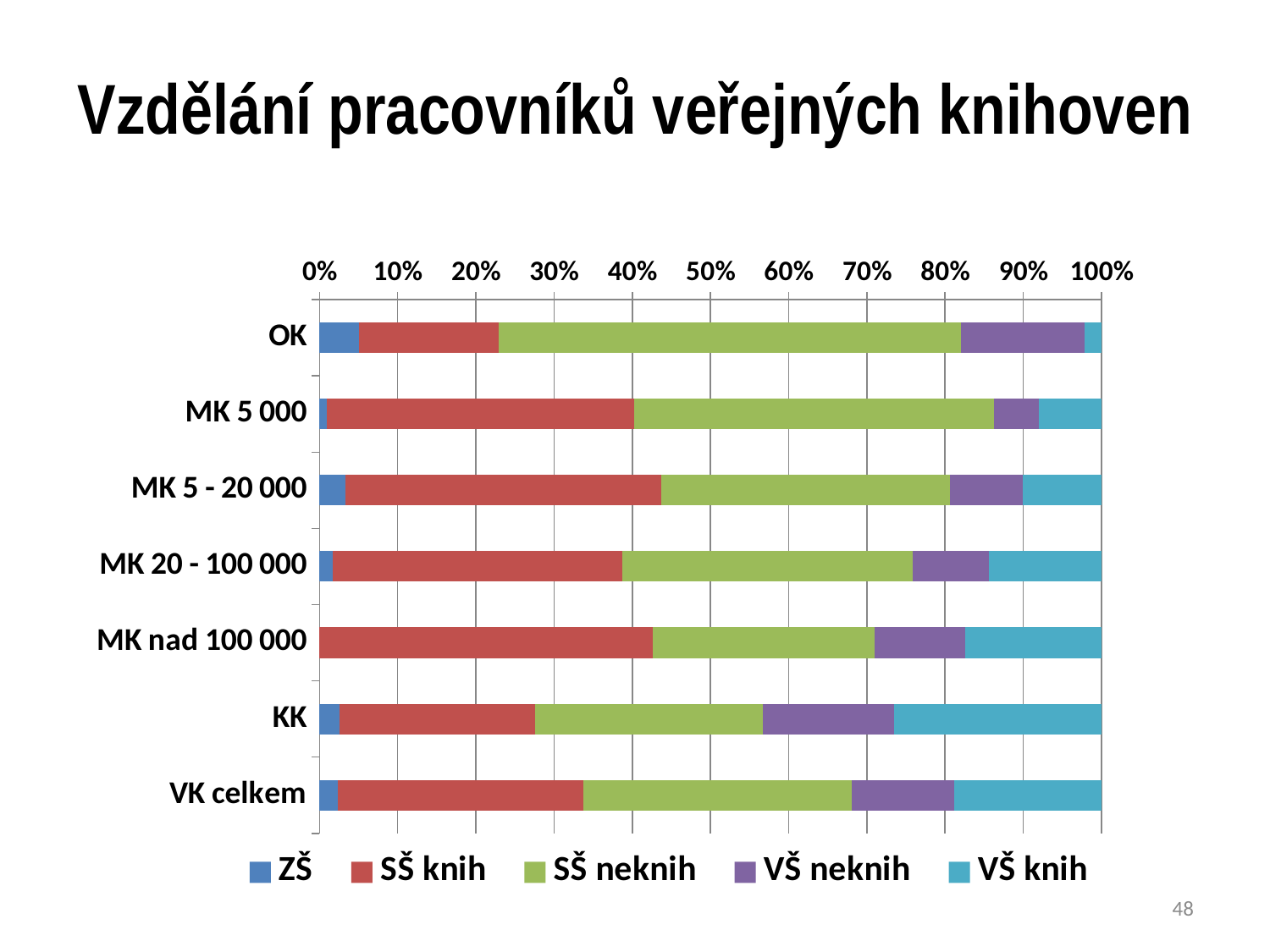
Which category has the largest VŠ knih share? KK Is the SŠ neknih share for OK greater or less than 50%? greater Is the ZŠ share for OK greater or less than 10%? less Which series is shown in red in the legend? SŠ knih What kind of chart is shown on the slide? stacked bar chart Is the VŠ knih share for KK greater or less than 20%? greater How many categories (library groups) are shown on the vertical axis? 7 Which category has the smallest VŠ knih share? OK What is the title of the chart? Vzdělání pracovníků veřejných knihoven How many series does the legend list? 5 Which is larger, the SŠ neknih share for OK or the SŠ neknih share for KK? OK